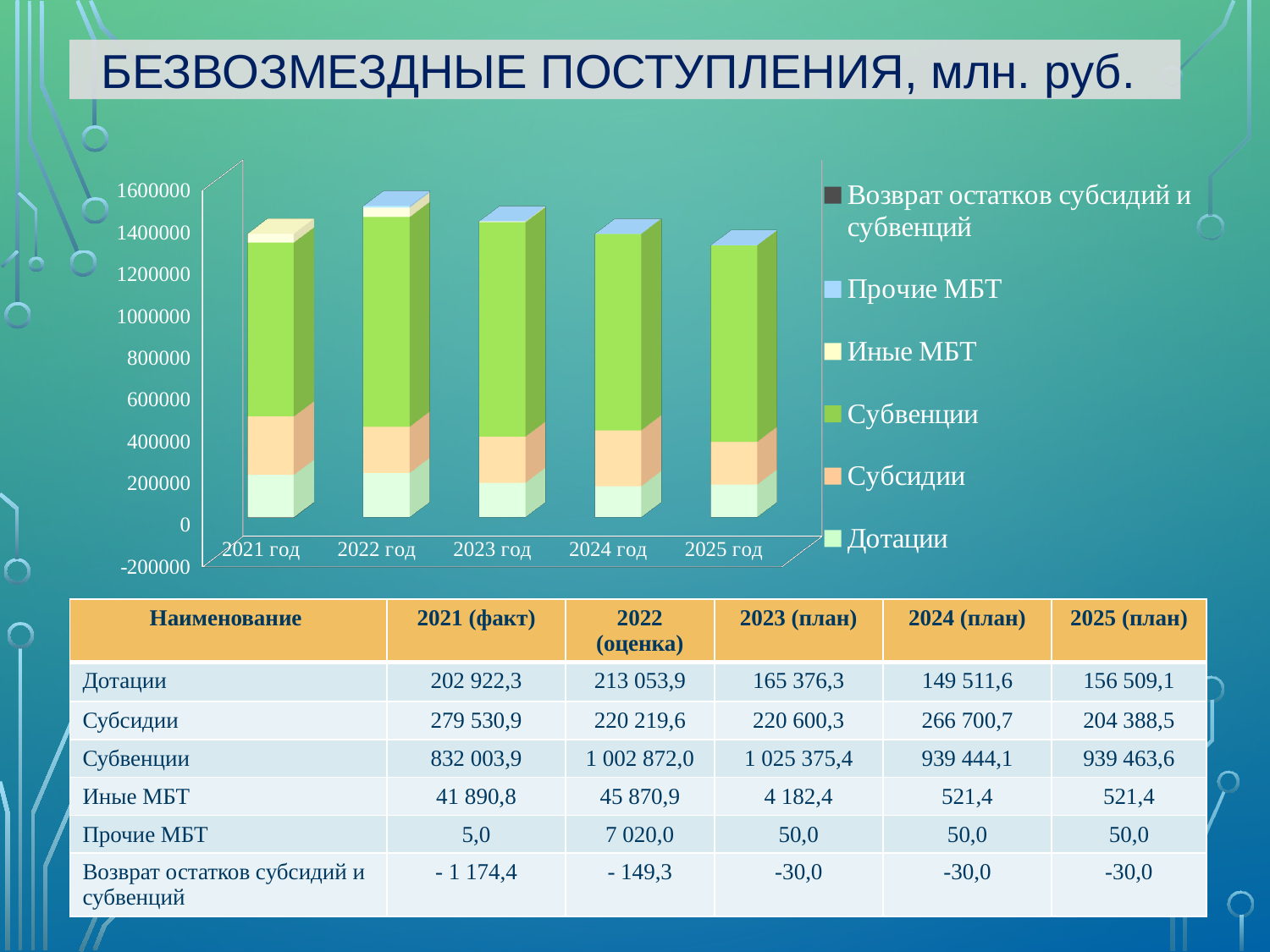
Which series is listed last (at the bottom) in the chart legend? Дотации How many years are shown along the x axis of the chart? 5 Is the Дотации segment of the 2021 год bar greater or less than 400000? less According to the table on the slide, what is the value of Субвенции for 2023 (план)? 1 025 375,4 Which year has the tallest stacked bar in the chart? 2022 год What kind of chart is shown on the slide? Stacked bar chart Is the total height of the stacked bar for 2022 год greater or less than 1400000? greater Do the values for Иные МБТ rise or fall from 2021 to 2025? fall How many series does the chart legend list? 6 Using the table values, what is the difference between Субсидии in 2024 (план) and 2025 (план)? 62 312,2 According to the table on the slide, what is the value of Дотации for 2021 (факт)? 202 922,3 Is the total height of the stacked bar for 2025 год greater or less than 1200000? greater